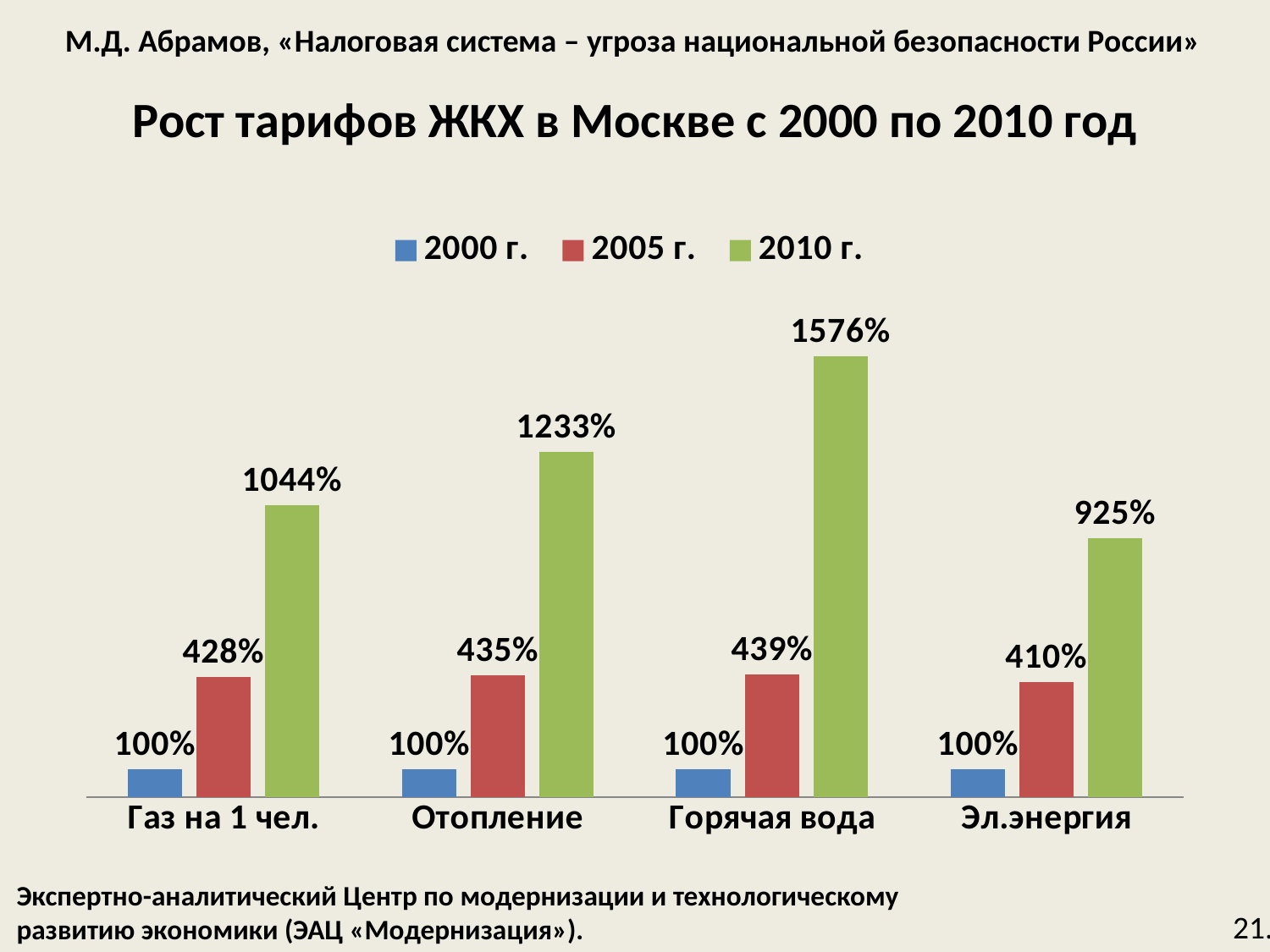
What is the value for Эл.энергия in the 2010 г. series? 925% What is the title of the chart? Рост тарифов ЖКХ в Москве с 2000 по 2010 год How many categories are shown on the x axis? 4 How many series does the legend list? 3 What is the difference between the 2010 г. and 2005 г. values for Газ на 1 чел.? 616% What is the value for Горячая вода in the 2010 г. series? 1576% Which category has the highest value in the 2010 г. series? Горячая вода Which category has the lowest value in the 2010 г. series? Эл.энергия Which is larger: the 2005 г. value for Горячая вода or the 2005 г. value for Эл.энергия? Горячая вода What is the value for Отопление in the 2005 г. series? 435% What kind of chart is shown on the slide? Bar chart Which colour represents the 2010 г. series? Green